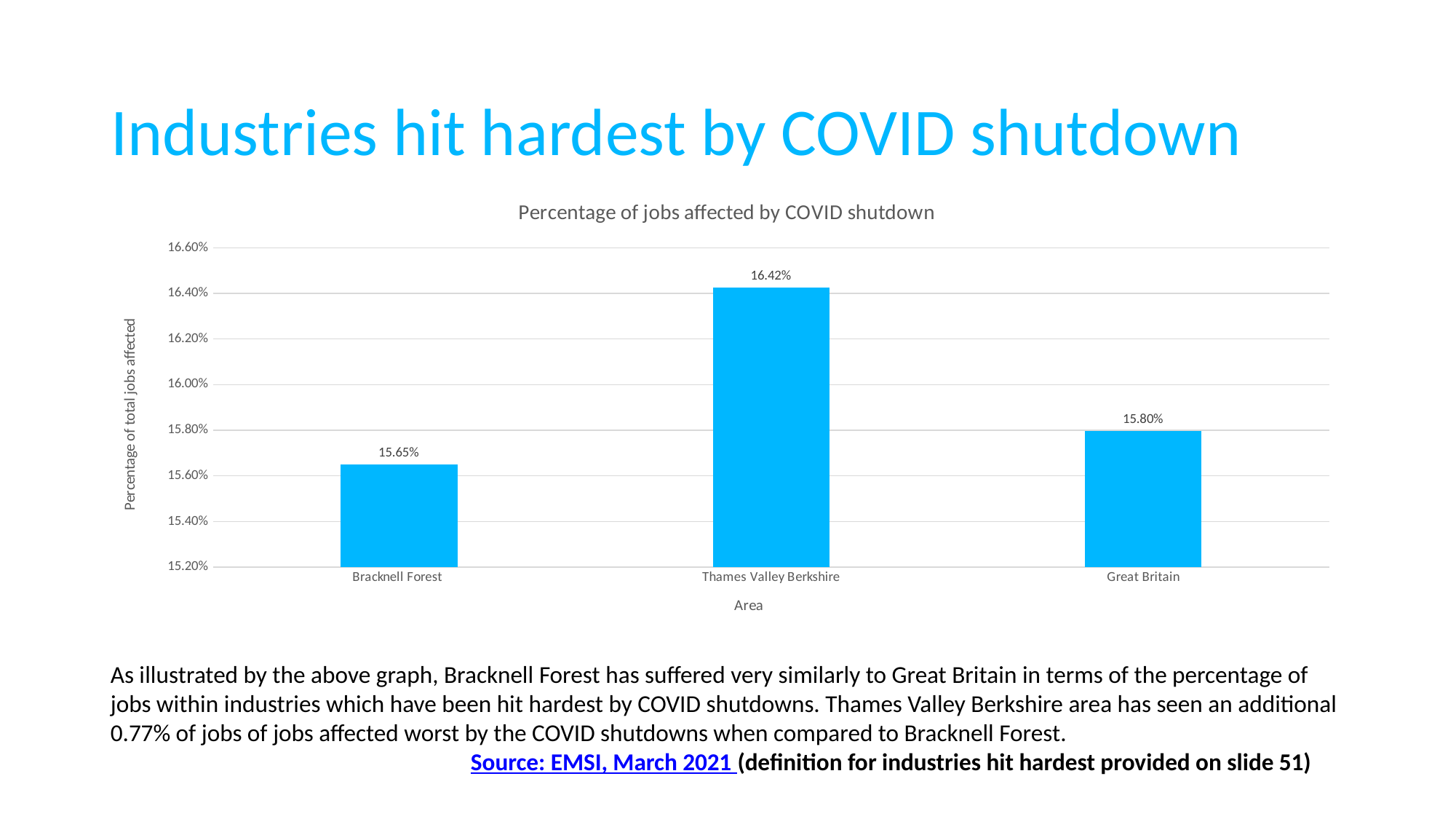
How many areas are shown on the chart? 3 What is the percentage of jobs affected by COVID shutdown for Bracknell Forest? 15.65% What is the difference in percentage points between Great Britain and Bracknell Forest? 0.15% Which has a higher percentage of jobs affected, Great Britain or Bracknell Forest? Great Britain What is the percentage of jobs affected by COVID shutdown for Great Britain? 15.80% What type of chart is shown on the slide? Bar chart What is the percentage of jobs affected by COVID shutdown for Thames Valley Berkshire? 16.42% Is the value for Thames Valley Berkshire greater or less than 16.00%? greater Which area has the lowest percentage of jobs affected by COVID shutdown? Bracknell Forest What is the difference in percentage points between Thames Valley Berkshire and Bracknell Forest? 0.77% What is the title of the chart? Percentage of jobs affected by COVID shutdown Which area has the highest percentage of jobs affected by COVID shutdown? Thames Valley Berkshire